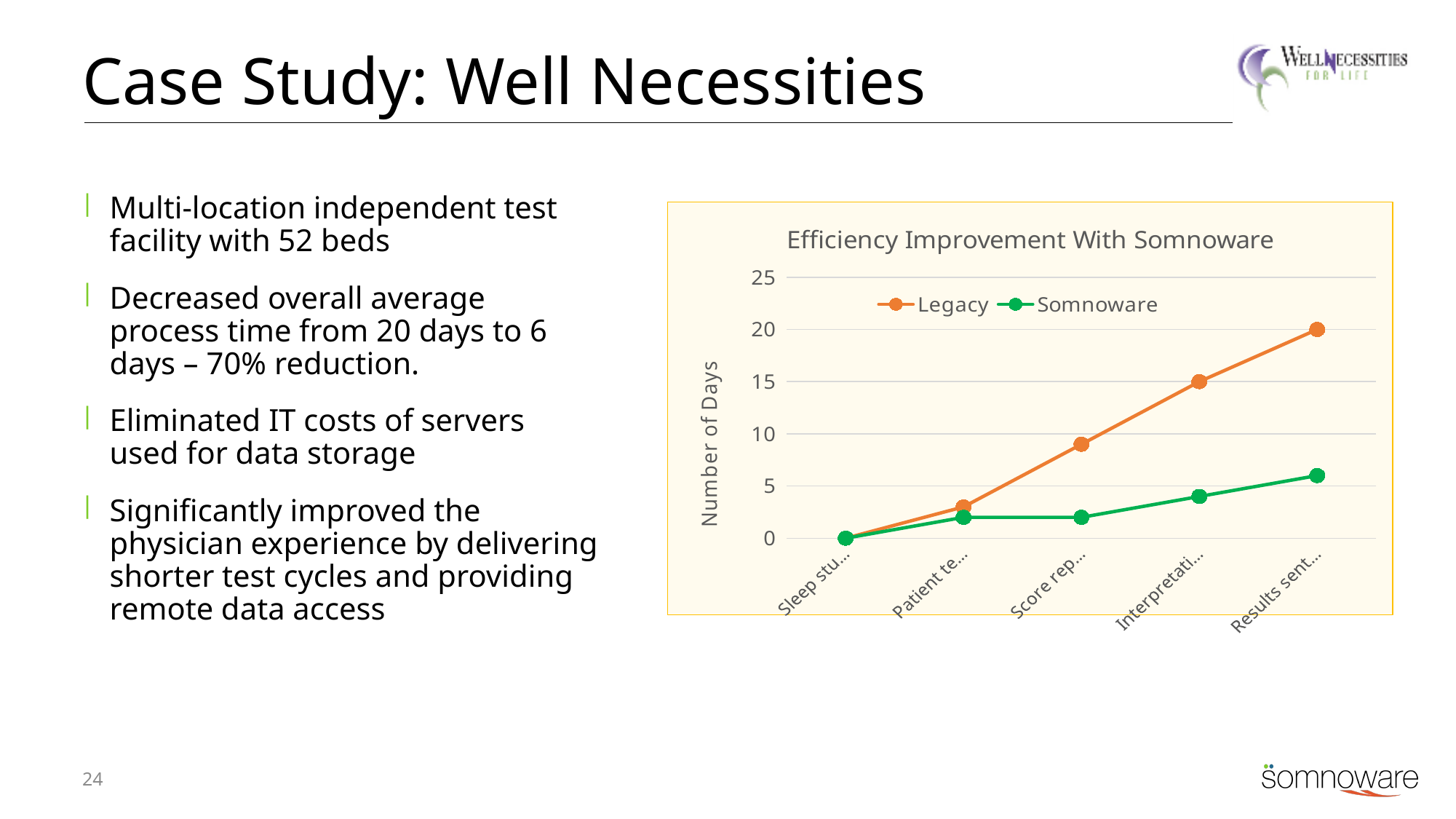
What is the y-axis label of the chart? Number of Days Which series is higher at the Results sent... category, Legacy or Somnoware? Legacy How many series does the chart legend list? 2 How many categories are plotted along the x axis of the chart? 5 What is the Legacy value at the last category (Results sent...)? 20 Is the Somnoware value at Results sent... greater or less than 10? less What is the title of the chart? Efficiency Improvement With Somnoware What is the difference between the Legacy values at Results sent... and Interpretati...? 5 What is the Legacy value at the Interpretati... category? 15 Do the Legacy values rise or fall from left to right along the x axis? Rise What type of chart is shown on the slide? Line chart Is the Legacy value at Score rep... greater or less than 5? greater